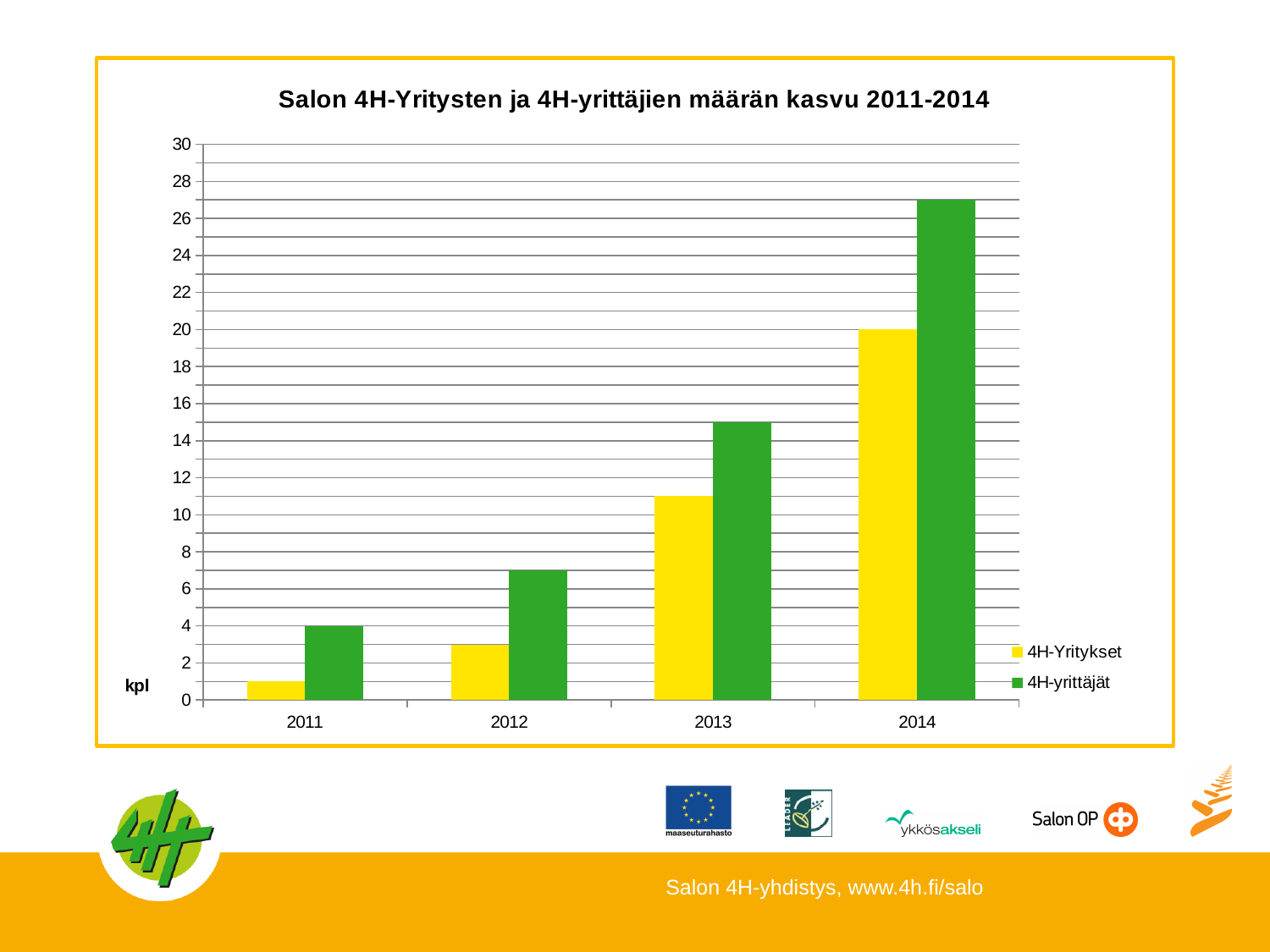
In 2012, which series has the larger value, 4H-Yritykset or 4H-yrittäjät? 4H-yrittäjät Is the value for 4H-yrittäjät in 2014 greater or less than 26? greater What kind of chart is shown on the slide? bar chart What is the value for 4H-yrittäjät in 2011? 4 Is the value for 4H-Yritykset in 2013 greater or less than 12? less What is the title of the chart? Salon 4H-Yritysten ja 4H-yrittäjien määrän kasvu 2011-2014 Which year has the highest value for 4H-yrittäjät? 2014 What is the value for 4H-Yritykset in 2014? 20 How many years are shown on the x axis? 4 Do the values for 4H-Yritykset rise or fall from 2011 to 2014? rise Which year has the lowest value for 4H-Yritykset? 2011 How many series does the legend list? 2